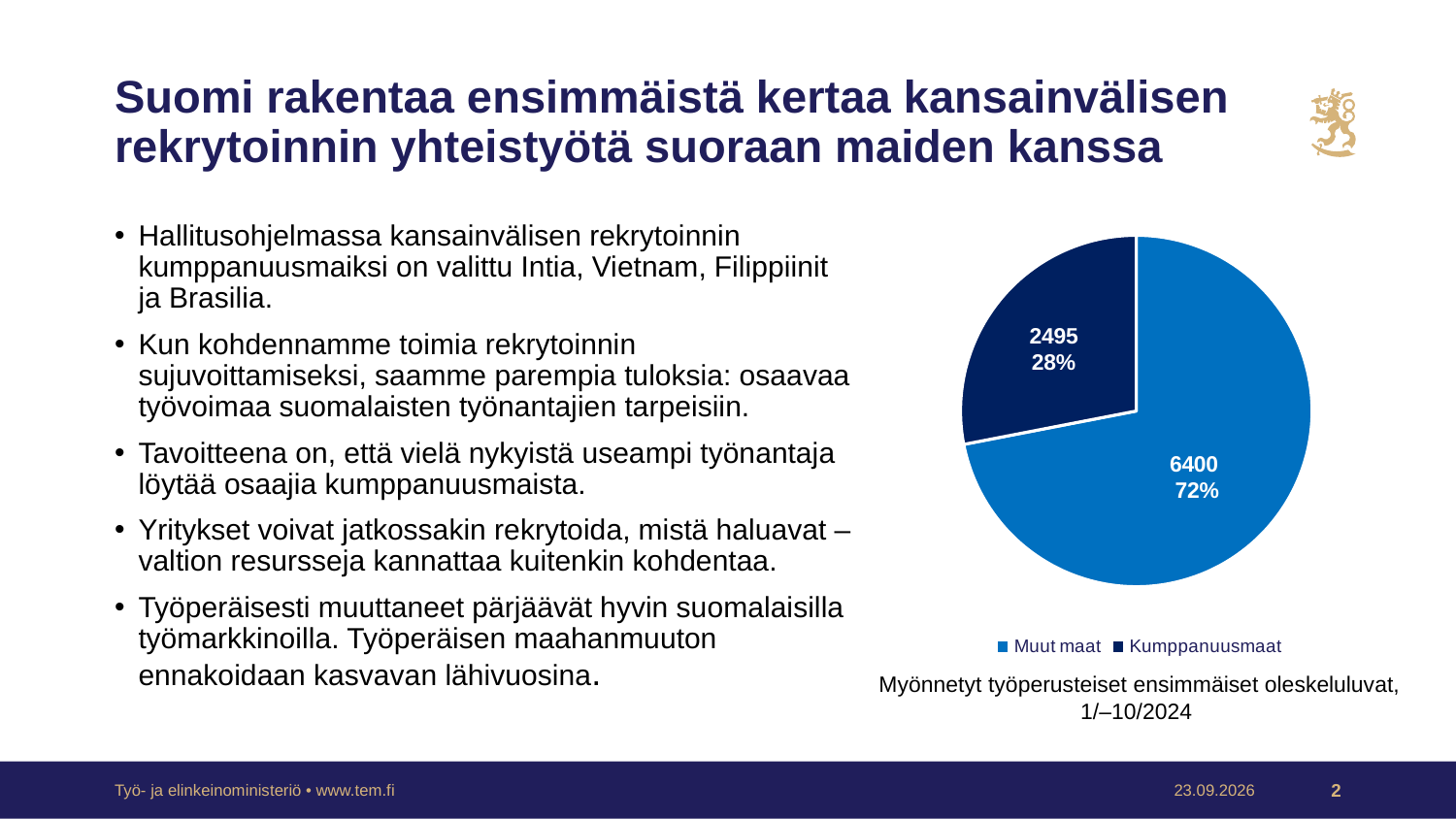
What is the difference between the values for Muut maat and Kumppanuusmaat? 3905 What is the value for Kumppanuusmaat in the pie chart? 2495 What share of the pie does Kumppanuusmaat represent? 28% What share of the pie does Muut maat represent? 72% How many slices does the pie chart have? 2 Which slice of the pie chart is the smallest? Kumppanuusmaat Which is larger, the value for Muut maat or the value for Kumppanuusmaat? Muut maat What kind of chart is shown on the slide? pie chart What caption is shown below the pie chart's legend? Myönnetyt työperusteiset ensimmäiset oleskeluluvat, 1/–10/2024 What is the total of the two values shown in the pie chart? 8895 Which slice of the pie chart is the largest? Muut maat What is the value for Muut maat in the pie chart? 6400